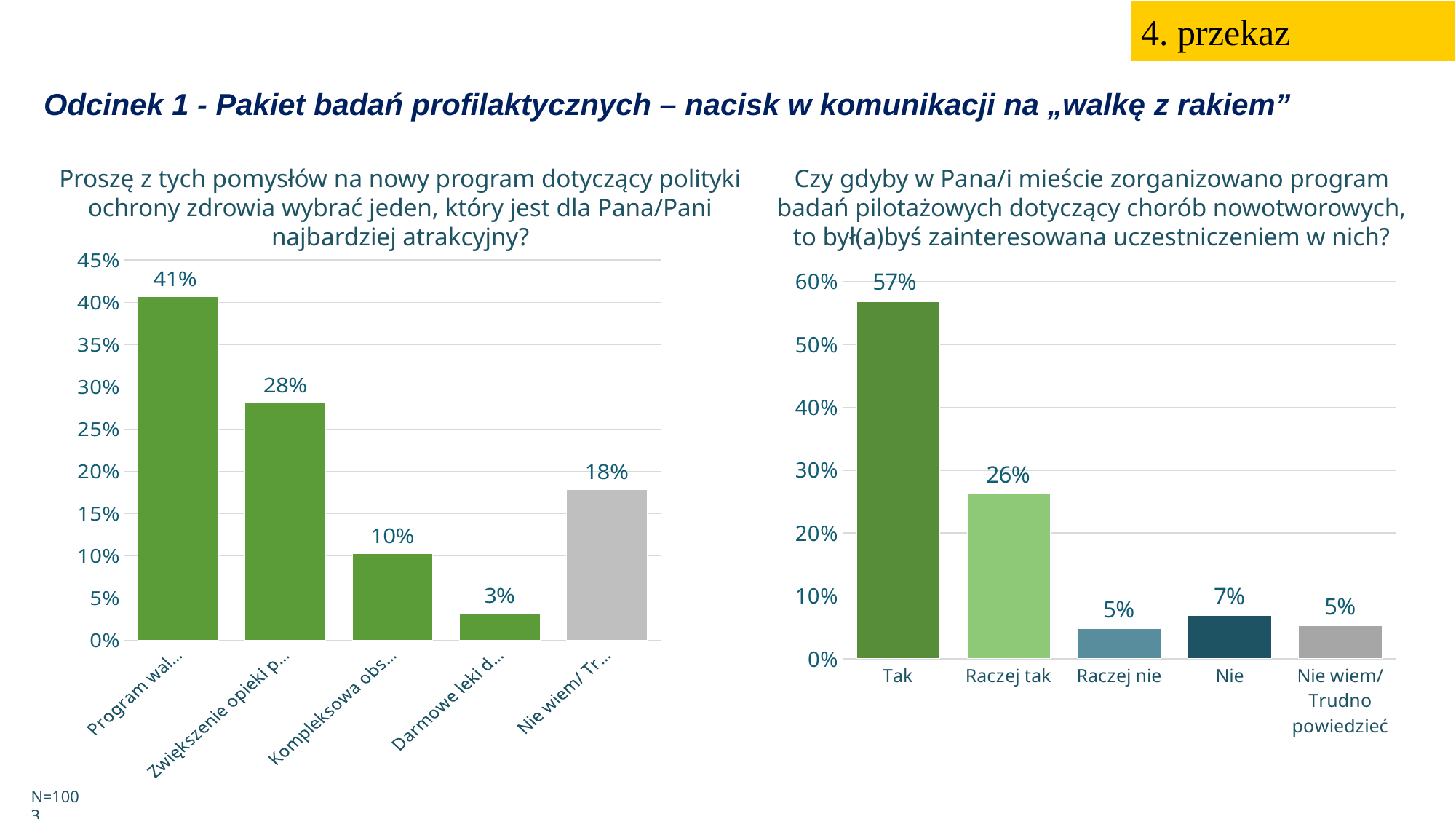
In the right chart, which is larger: "Nie" or "Raczej nie"? Nie In the left chart, what is the difference between the first bar (41%) and the second bar (28%)? 13 percentage points In the right chart, how many categories are shown on the x axis? 5 What type of chart is the left chart? Bar chart In the left chart, which bar has the lowest value? Darmowe leki d... (3%) In the right chart, what is the value for "Raczej tak"? 26% In the right chart, what is the value for "Nie"? 7% In the left chart ("Proszę z tych pomysłów na nowy program..."), what is the value of the first bar ("Program wal...")? 41% In the right chart, which category has the highest value? Tak In the left chart, what is the value of the bar labelled "Nie wiem/ Tr..."? 18% In the right chart ("Czy gdyby w Pana/i mieście zorganizowano program badań pilotażowych..."), what is the value for "Tak"? 57% In the right chart, what is the difference between "Tak" and "Raczej tak"? 31 percentage points